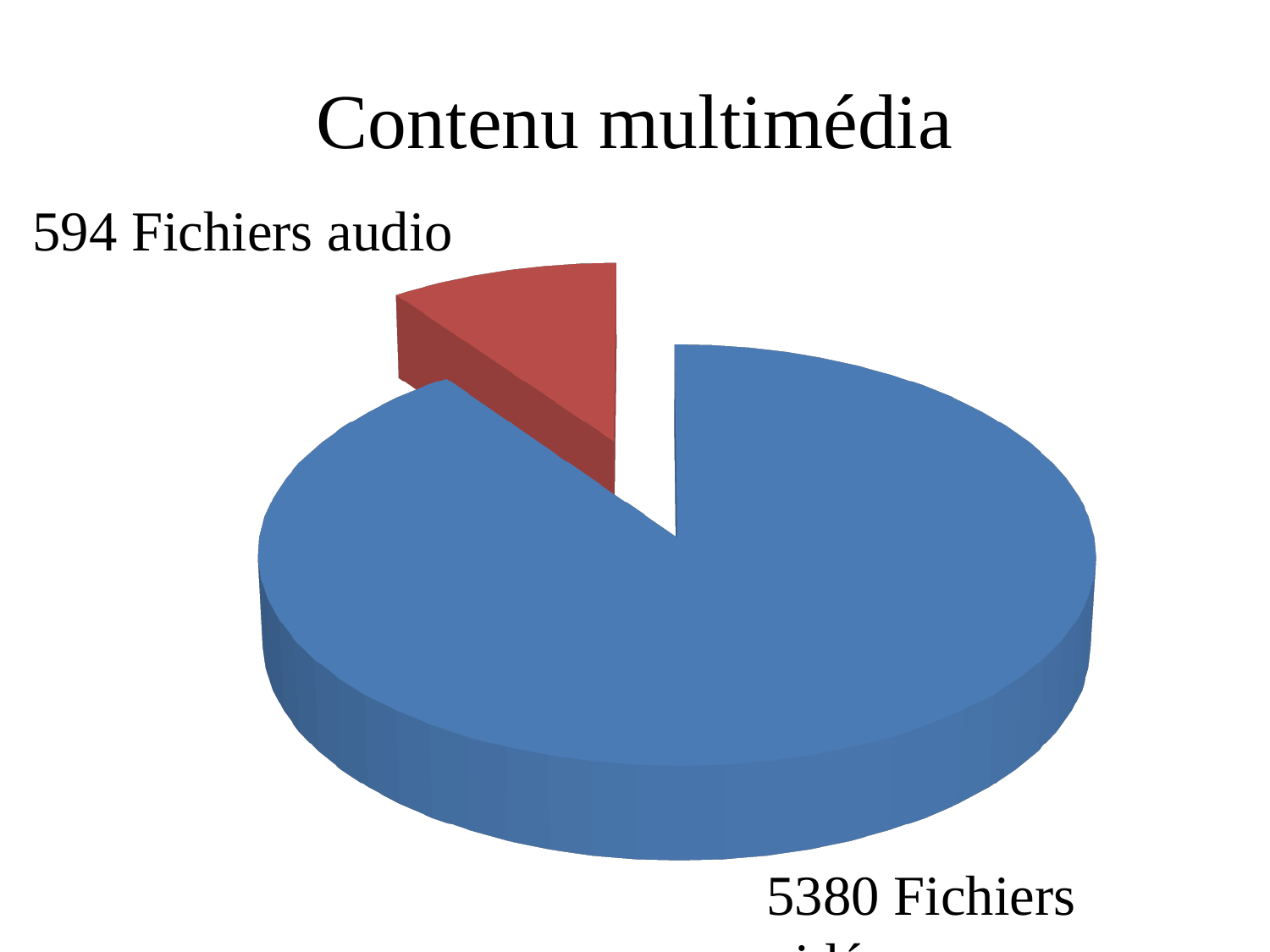
What colour is the Fichiers audio slice? red What kind of chart is shown on the slide? pie chart What is the total of the two values shown on the pie chart? 5974 What is the title of the chart? Contenu multimédia Which is larger: the number of Fichiers audio or the value of the blue slice? the blue slice (5380) How many slices does the pie chart have? 2 What value is shown for the large blue slice of the pie? 5380 How many audio files (Fichiers audio) are shown on the chart? 594 Is the Fichiers audio slice more or less than half of the pie? less What is the difference between the blue slice value (5380) and the Fichiers audio value (594)? 4786 Which slice of the pie is the smallest? Fichiers audio (594) Which slice of the pie is the largest? the blue slice (5380 Fichiers)